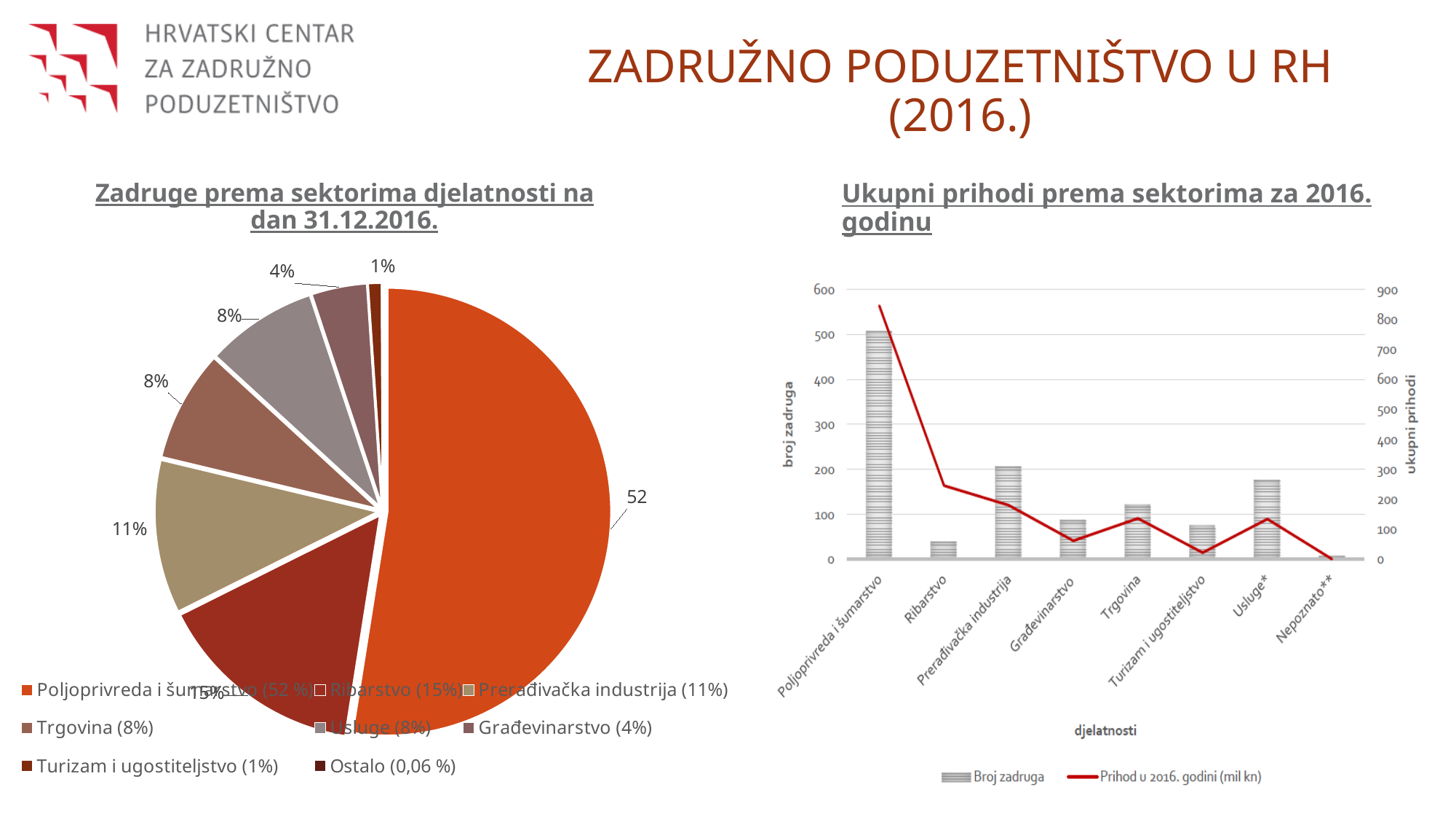
In the pie chart on the left, what share of the pie does Ribarstvo have? 15% In the right chart, is the Broj zadruga bar for Poljoprivreda i šumarstvo greater or less than 400? greater In the right chart "Ukupni prihodi prema sektorima za 2016. godinu", how many categories are shown on the x axis? 8 How many entries does the legend of the pie chart on the left list? 8 In the pie chart on the left, what share of the pie does Prerađivačka industrija have? 11% What kind of chart is the left chart titled "Zadruge prema sektorima djelatnosti na dan 31.12.2016."? pie chart In the right chart, which category has the lowest bar for Broj zadruga? Nepoznato** In the pie chart on the left, which sector has the largest slice? Poljoprivreda i šumarstvo In the right chart "Ukupni prihodi prema sektorima za 2016. godinu", how many series does the legend list? 2 In the right chart, which has the taller Broj zadruga bar, Prerađivačka industrija or Trgovina? Prerađivačka industrija In the right chart, which category has the highest bar for Broj zadruga? Poljoprivreda i šumarstvo In the pie chart on the left, what share does Građevinarstvo have? 4%